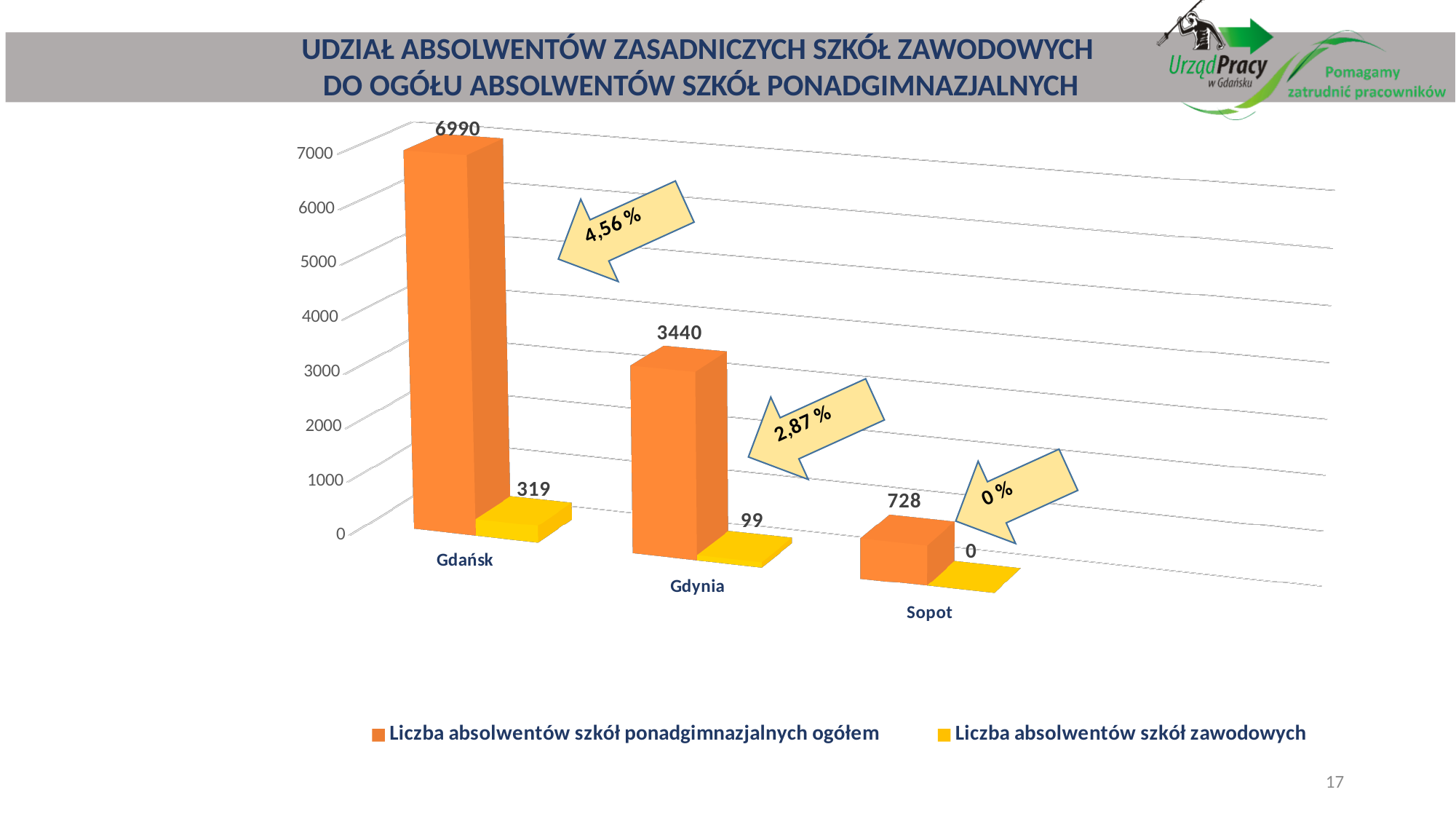
What is the value of 'Liczba absolwentów szkół ponadgimnazjalnych ogółem' for Sopot? 728 Which is larger: 'Liczba absolwentów szkół zawodowych' for Gdańsk or for Gdynia? Gdańsk What is the difference between the 'Liczba absolwentów szkół ponadgimnazjalnych ogółem' values for Gdańsk and Gdynia? 3550 How many series does the legend list? 2 Which city has the lowest value for 'Liczba absolwentów szkół zawodowych'? Sopot What is the value of 'Liczba absolwentów szkół zawodowych' for Gdynia? 99 What is the value of 'Liczba absolwentów szkół ponadgimnazjalnych ogółem' for Gdańsk? 6990 How many cities are shown on the x axis? 3 What percentage is shown in the arrow callout for Gdynia? 2,87 % What is the value of 'Liczba absolwentów szkół zawodowych' for Gdańsk? 319 Which city has the highest value for 'Liczba absolwentów szkół ponadgimnazjalnych ogółem'? Gdańsk What kind of chart is shown on the slide? Bar chart